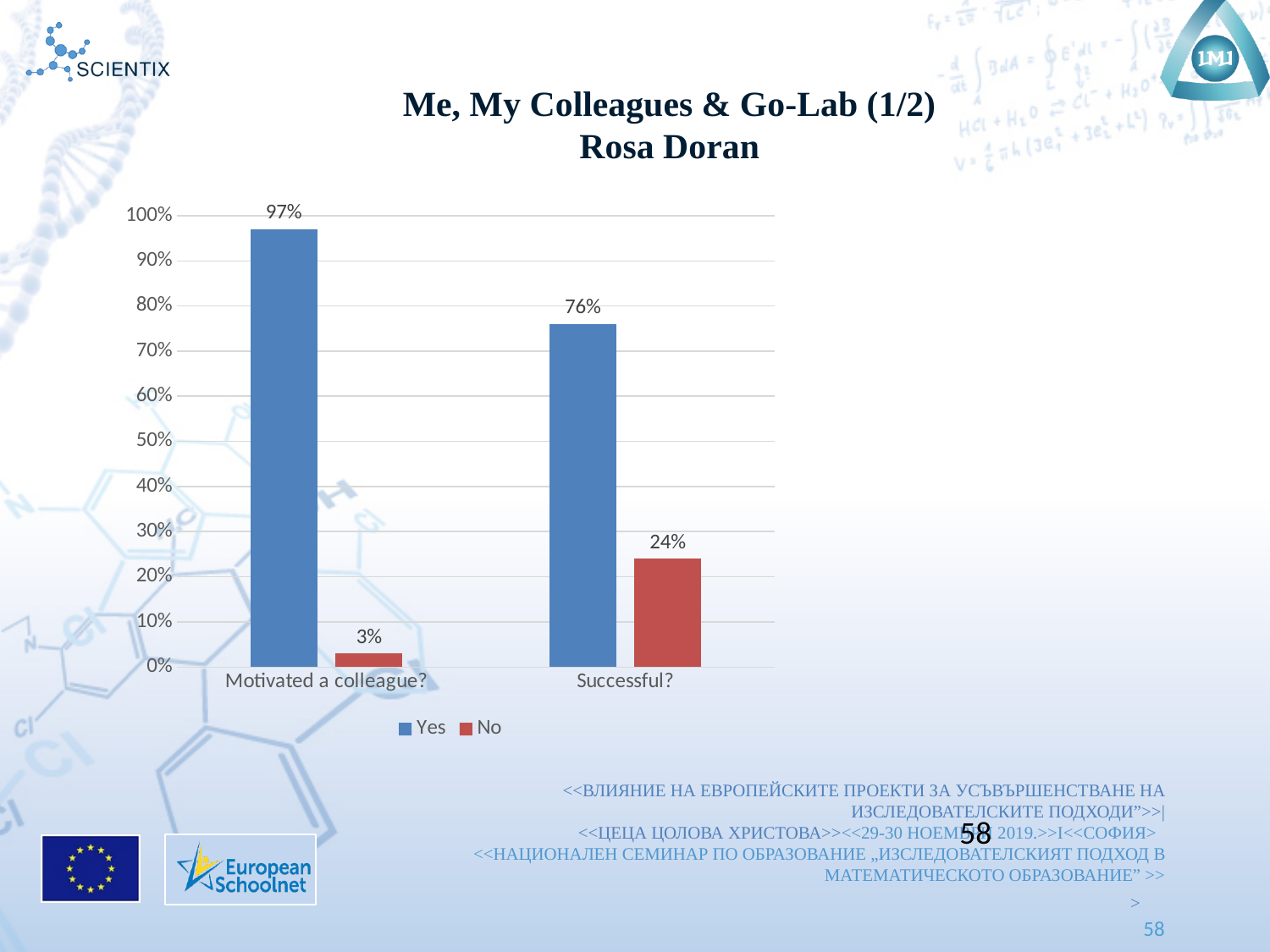
Which category has the lowest No value? Motivated a colleague? Which is larger: the Yes value for "Successful?" or the Yes value for "Motivated a colleague?"? Motivated a colleague? How many categories are shown on the x axis? 2 How many series does the legend list? 2 Which category has the highest Yes value? Motivated a colleague? What kind of chart is shown on the slide? Bar chart What is the value of the No series for "Successful?"? 24% What is the value of the No series for "Motivated a colleague?"? 3% What colour are the bars for the No series? Red What is the value of the Yes series for "Successful?"? 76% What is the difference between the Yes and No values for "Successful?"? 52% What is the value of the Yes series for "Motivated a colleague?"? 97%